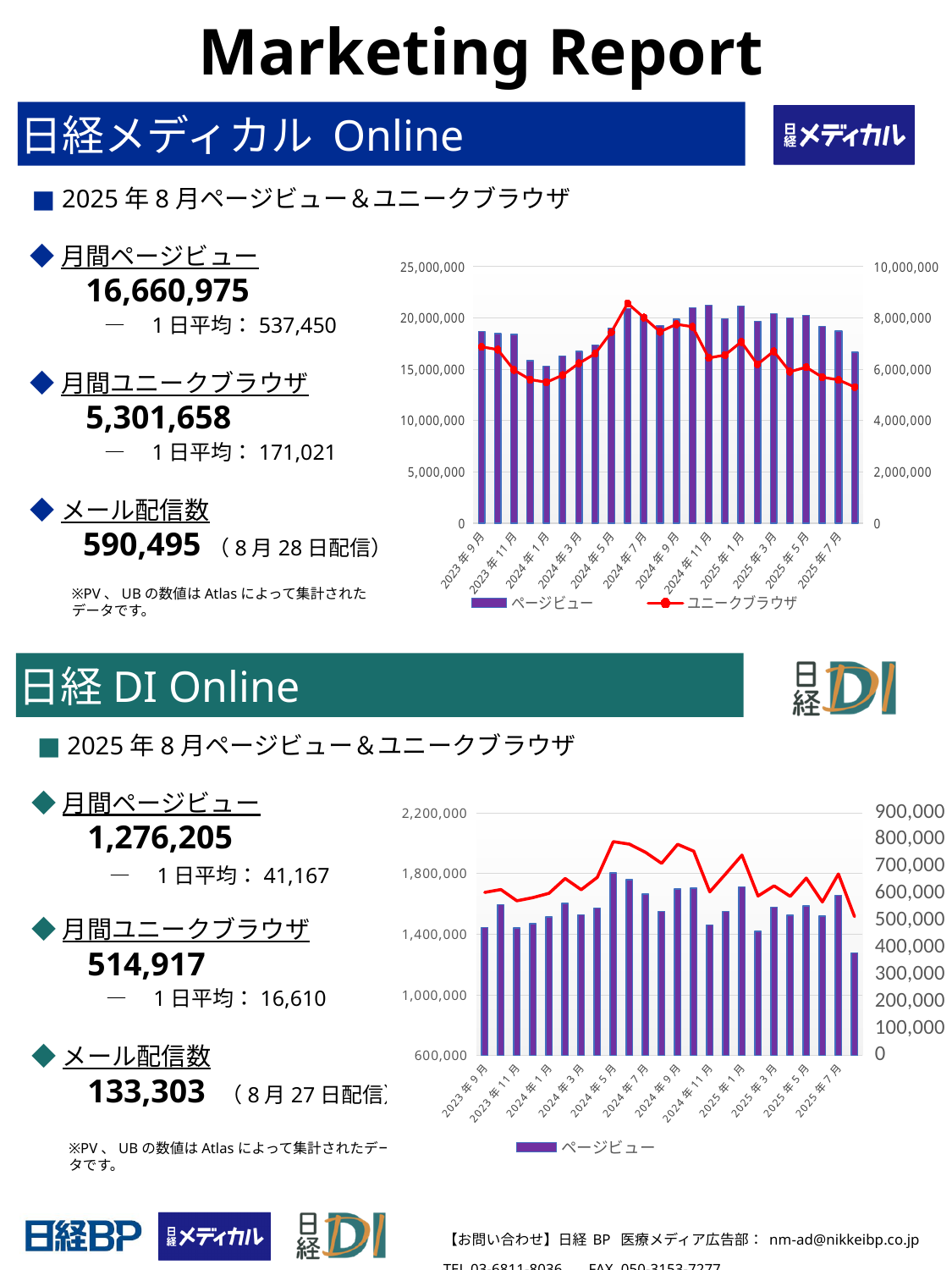
What kind of chart is the top chart (日経メディカル Online)? A combined bar and line chart In the bottom chart (日経DI Online), how many series does the legend list? 1 In the top chart (日経メディカル Online), does the ユニークブラウザ line generally rise or fall from 2024年7月 to 2025年7月? fall In the bottom chart (日経DI Online), in which month is the ページビュー bar highest? 2024年5月 In the top chart (日経メディカル Online), what are the two legend entries? ページビュー and ユニークブラウザ In the top chart (日経メディカル Online), is the ページビュー value for 2024年1月 greater or less than 20,000,000? less In the top chart (日経メディカル Online), how many month labels are shown on the x axis? 12 In the top chart (日経メディカル Online), how many series does the legend list? 2 In the bottom chart (日経DI Online), is the ページビュー value for 2024年5月 greater or less than 1,400,000? greater In the bottom chart (日経DI Online), which is larger, the ページビュー bar for 2024年5月 or the ページビュー bar for 2025年7月? 2024年5月